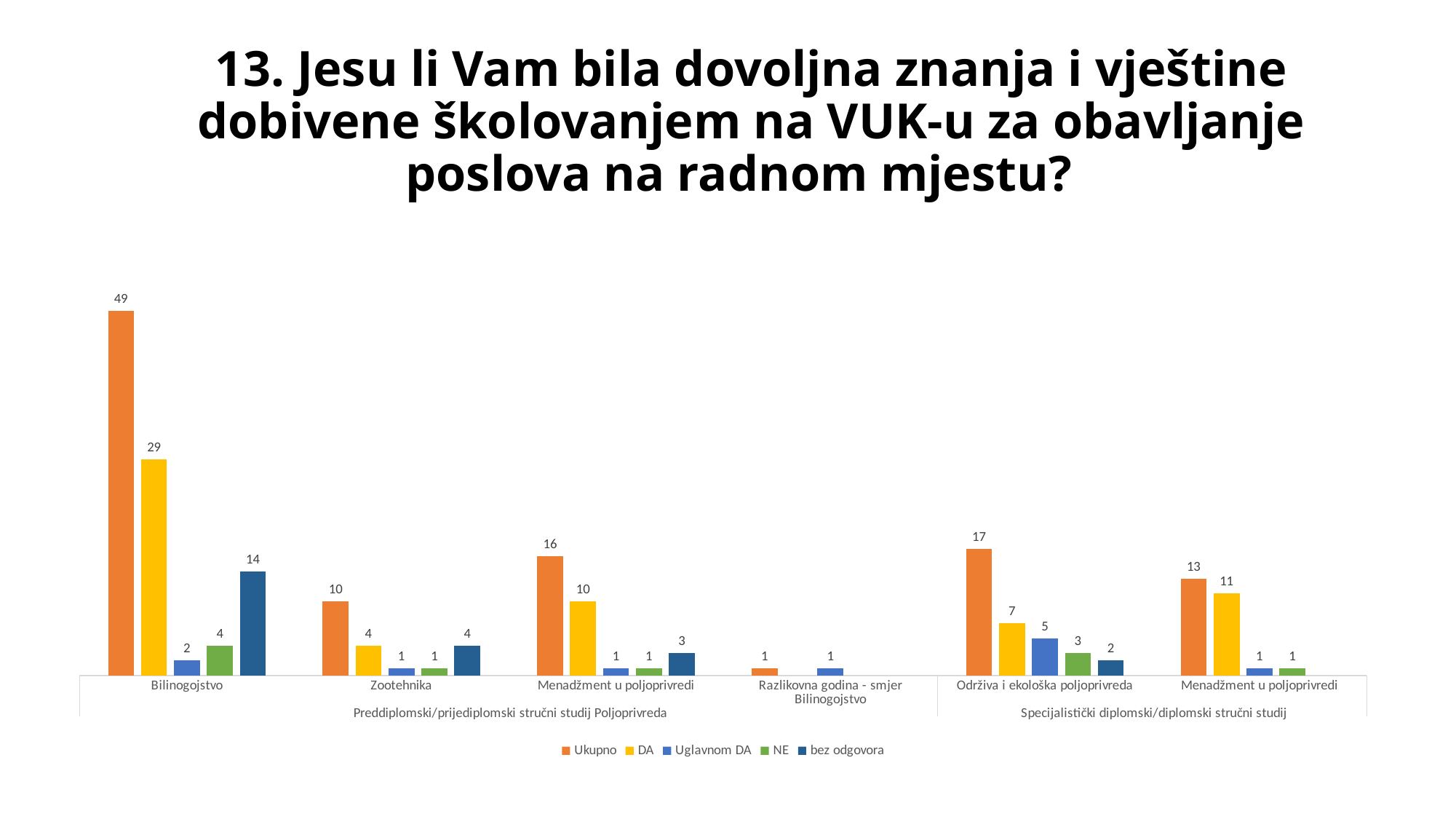
What is the DA value for Menadžment u poljoprivredi under Specijalistički diplomski/diplomski stručni studij? 11 How many categories are shown on the x axis? 6 What is the DA value for Održiva i ekološka poljoprivreda? 7 Which category has the lowest Ukupno value? Razlikovna godina - smjer Bilinogojstvo What kind of chart is shown on the slide? Bar chart How many series does the legend list? 5 What is the bez odgovora value for Zootehnika? 4 What is the difference between the Ukupno and DA values for Bilinogojstvo? 20 What is the Ukupno value for Bilinogojstvo? 49 Which is larger: the Ukupno value for Održiva i ekološka poljoprivreda or the Ukupno value for Menadžment u poljoprivredi under Preddiplomski/prijediplomski stručni studij Poljoprivreda? Održiva i ekološka poljoprivreda Which category has the highest Ukupno value? Bilinogojstvo What colour are the bars for the DA series? Yellow